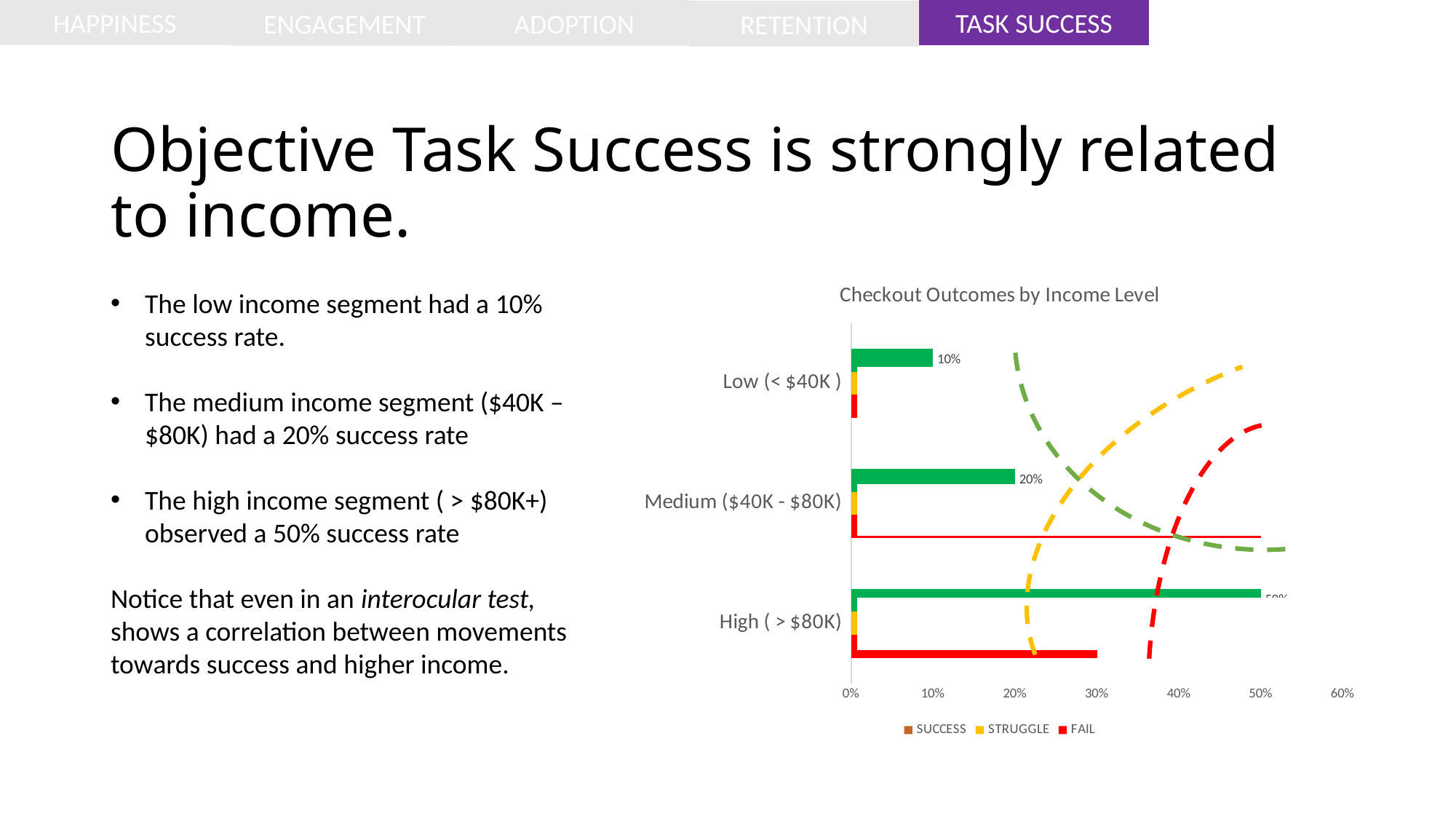
How many income level categories does the chart show? 3 What type of chart is shown on the slide? bar chart What is the SUCCESS value for the Low (< $40K ) income level? 10% Which has a larger SUCCESS value, the Medium ($40K - $80K) or the Low (< $40K ) income level? Medium ($40K - $80K) What is the difference between the SUCCESS values for the High ( > $80K) and Low (< $40K ) income levels? 40% What is the title of the chart? Checkout Outcomes by Income Level What is the SUCCESS value for the High ( > $80K) income level? 50% Is the FAIL value for the High ( > $80K) income level greater or less than 20%? greater Which income level has the highest SUCCESS value? High ( > $80K) Which income level has the lowest SUCCESS value? Low (< $40K ) What is the SUCCESS value for the Medium ($40K - $80K) income level? 20% How many series does the chart legend list? 3